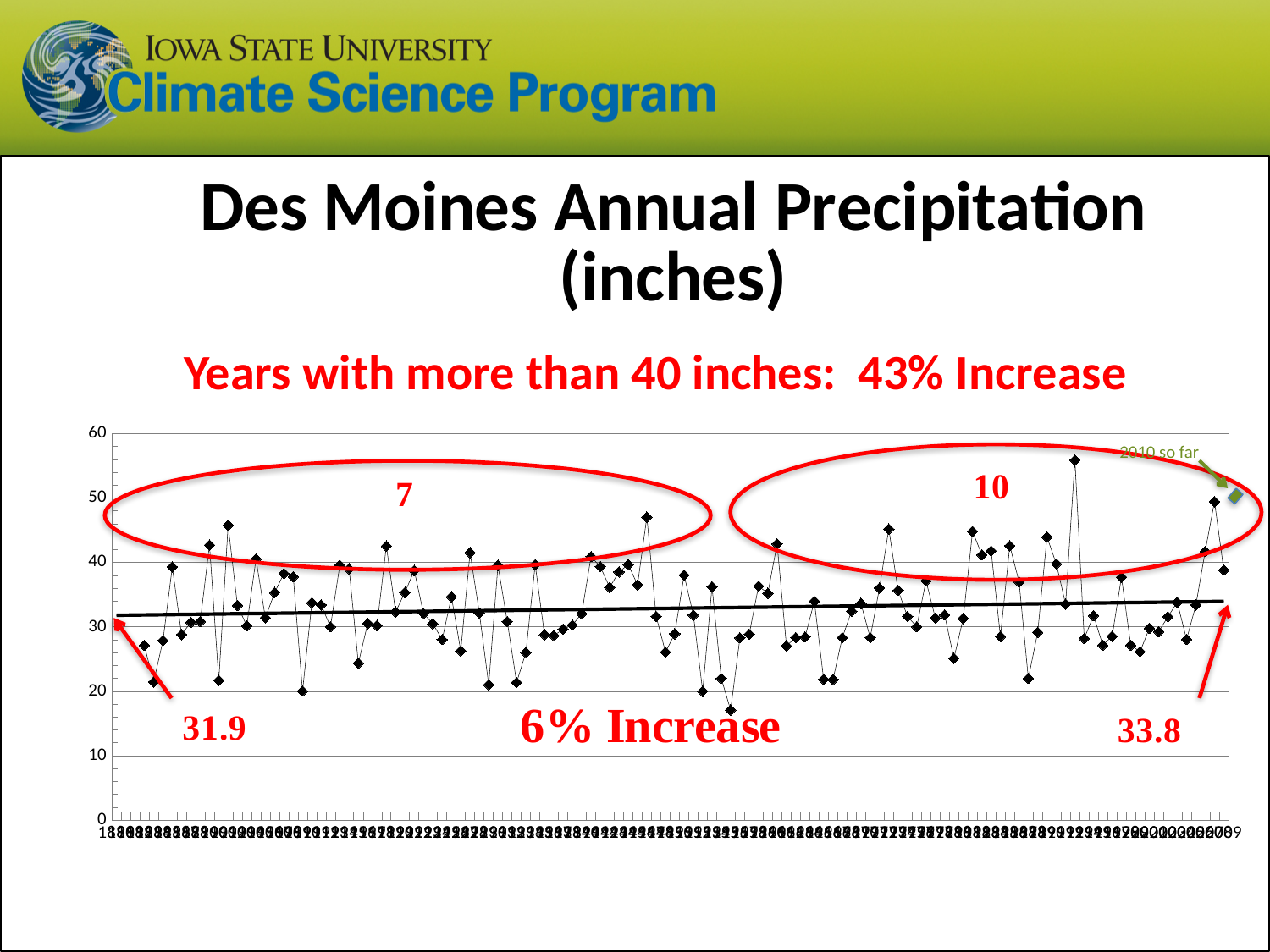
What value is labelled at the left (start) end of the trend line? 31.9 What value is labelled at the right (end) end of the trend line? 33.8 What is the title of the chart? Des Moines Annual Precipitation (inches) Does the trend line drawn through the precipitation data rise or fall from left to right? rise What is the difference between the trend line's end value (33.8) and its start value (31.9)? 1.9 Is the highest plotted annual precipitation value greater or less than 50? greater How many years with more than 40 inches are counted in the left red circle? 7 Which is larger, the trend line value at the start (31.9) or at the end (33.8)? 33.8 (end) What percentage increase is labelled on the trend line in the chart? 6% Increase What kind of chart is shown on the slide? line chart How many years with more than 40 inches are counted in the right red circle? 10 Is the lowest plotted annual precipitation value greater or less than 20? less